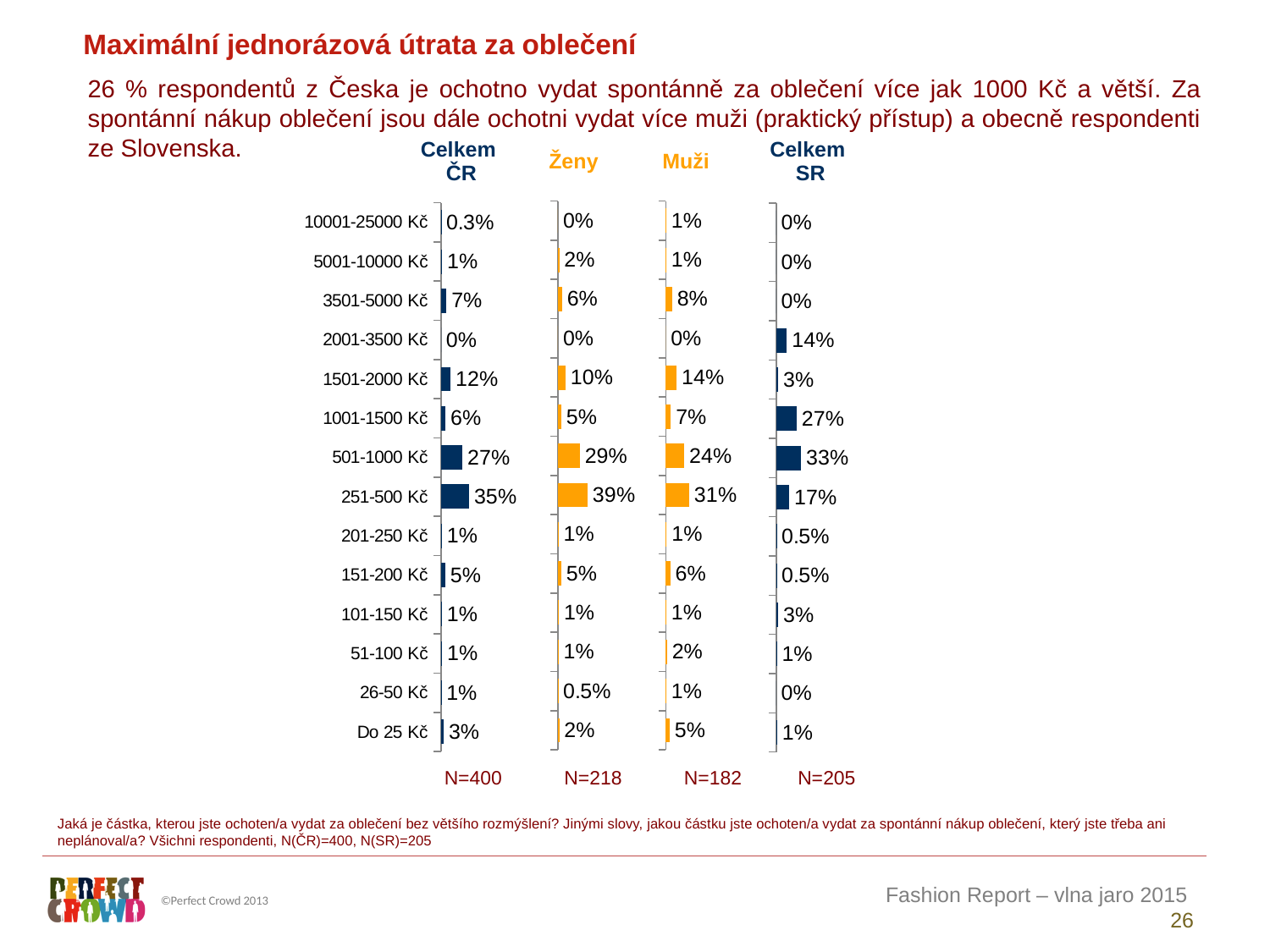
In the Ženy chart, which category has the highest value? 251-500 Kč In the Celkem SR chart, what is the value for 1001-1500 Kč? 27% Which is larger: the value for 251-500 Kč in the Ženy chart or in the Muži chart? Ženy In the Muži chart, what is the difference between the values for 251-500 Kč and 501-1000 Kč? 7% What is the sample size (N) shown under the Muži chart? N=182 In the Muži chart, what is the value for 1501-2000 Kč? 14% In the Celkem ČR chart, what is the value for 251-500 Kč? 35% What type of chart is used for the Celkem ČR data? Bar chart In the Celkem SR chart, which category has the highest value? 501-1000 Kč In the Celkem SR chart, what is the value for 2001-3500 Kč? 14% How many spending categories are shown in the Celkem ČR chart? 14 In the Ženy chart, what is the value for 501-1000 Kč? 29%